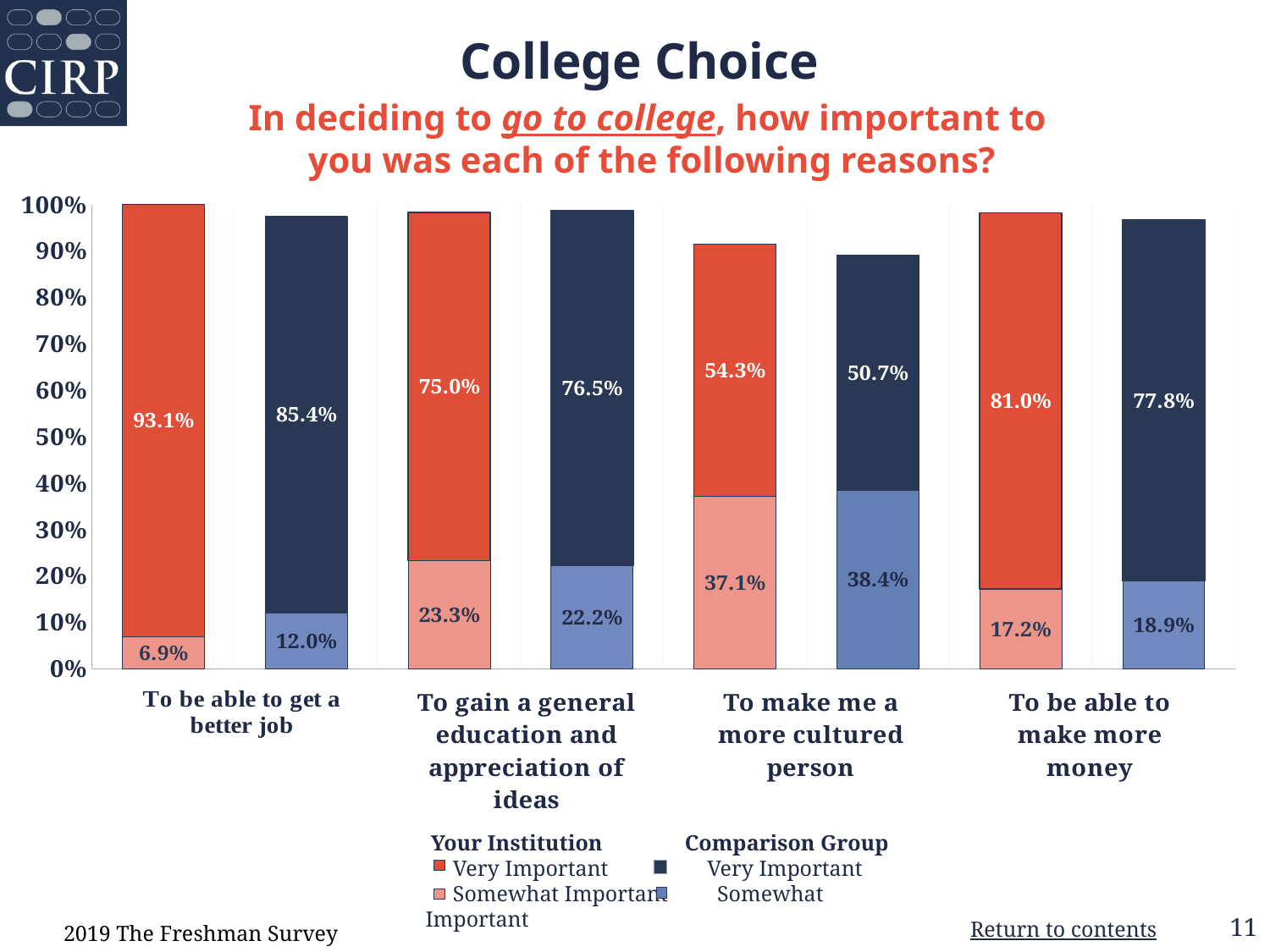
What is the total of the Your Institution stacked bar for "To make me a more cultured person"? 91.4% What percentage of Your Institution students rated "To be able to get a better job" as Very Important? 93.1% For "To gain a general education and appreciation of ideas", which group has the larger Very Important percentage, Your Institution or the Comparison Group? Comparison Group How many series does the legend list? 4 What is the total of the Comparison Group stacked bar for "To be able to make more money"? 96.7% Which reason has the highest Very Important percentage for Your Institution? To be able to get a better job What percentage of the Comparison Group rated "To make me a more cultured person" as Somewhat Important? 38.4% What is the difference between the Your Institution and Comparison Group Very Important percentages for "To be able to get a better job"? 7.7% What kind of chart is shown on the slide? Stacked bar chart Which reason has the lowest Very Important percentage for the Comparison Group? To make me a more cultured person How many reasons (categories) are shown on the x axis? 4 What percentage of Your Institution students rated "To be able to make more money" as Very Important? 81.0%